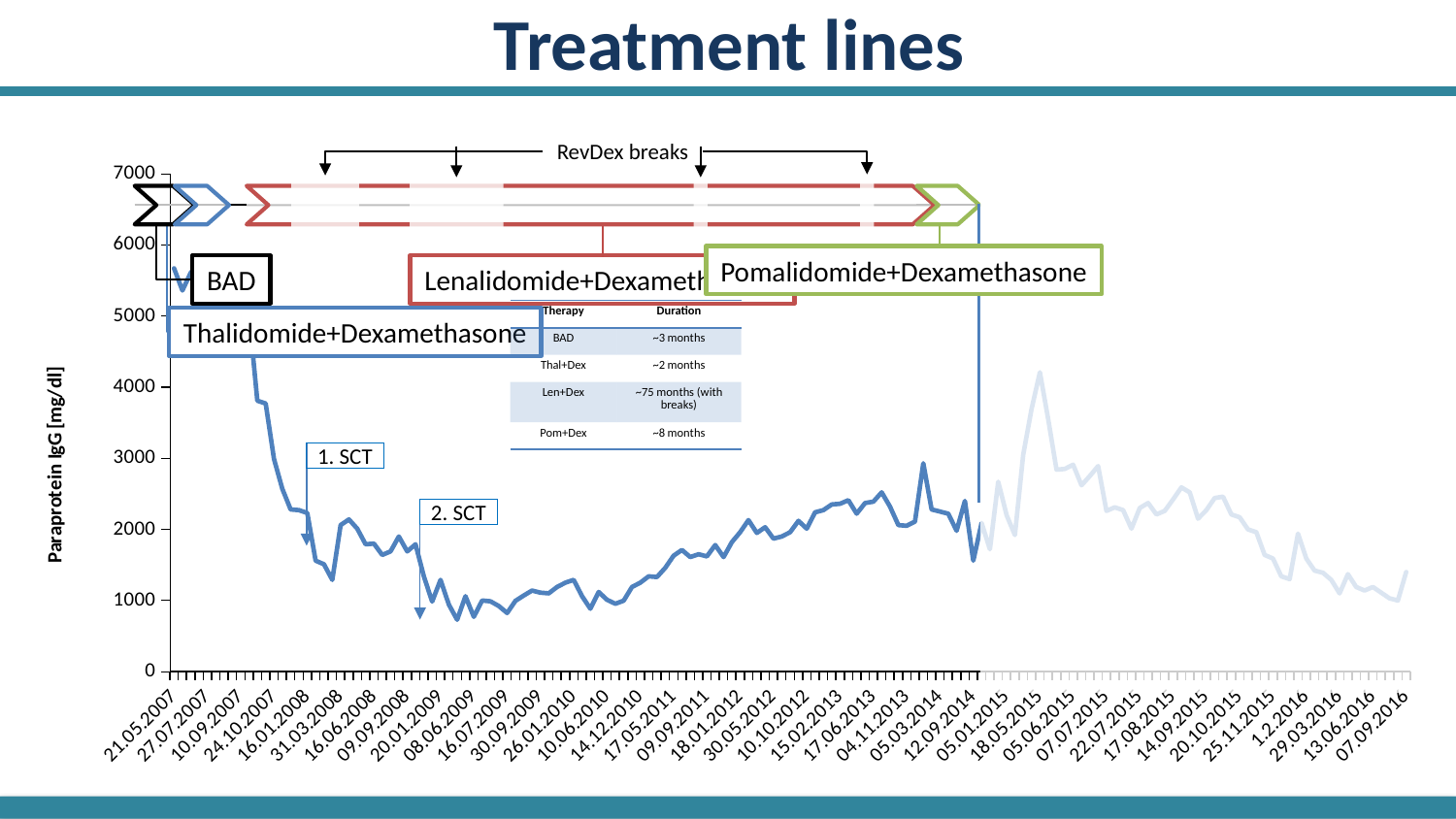
Does the paraprotein line rise or fall between 10.06.2010 and 15.02.2013? rise What kind of chart is shown on the slide? line chart Is the value of the paraprotein line at 15.02.2013 greater or less than 2000? greater Is the value of the paraprotein line at 17.05.2011 greater or less than 2000? less Is the value of the paraprotein line at 10.06.2010 greater or less than 2000? less What is the title of the slide containing the chart? Treatment lines What is the label of the vertical axis of the chart? Paraprotein IgG [mg/dl] Does the paraprotein line rise or fall between 21.05.2007 and 20.01.2009? fall Does the paraprotein line rise or fall between 05.06.2015 and 07.09.2016? fall